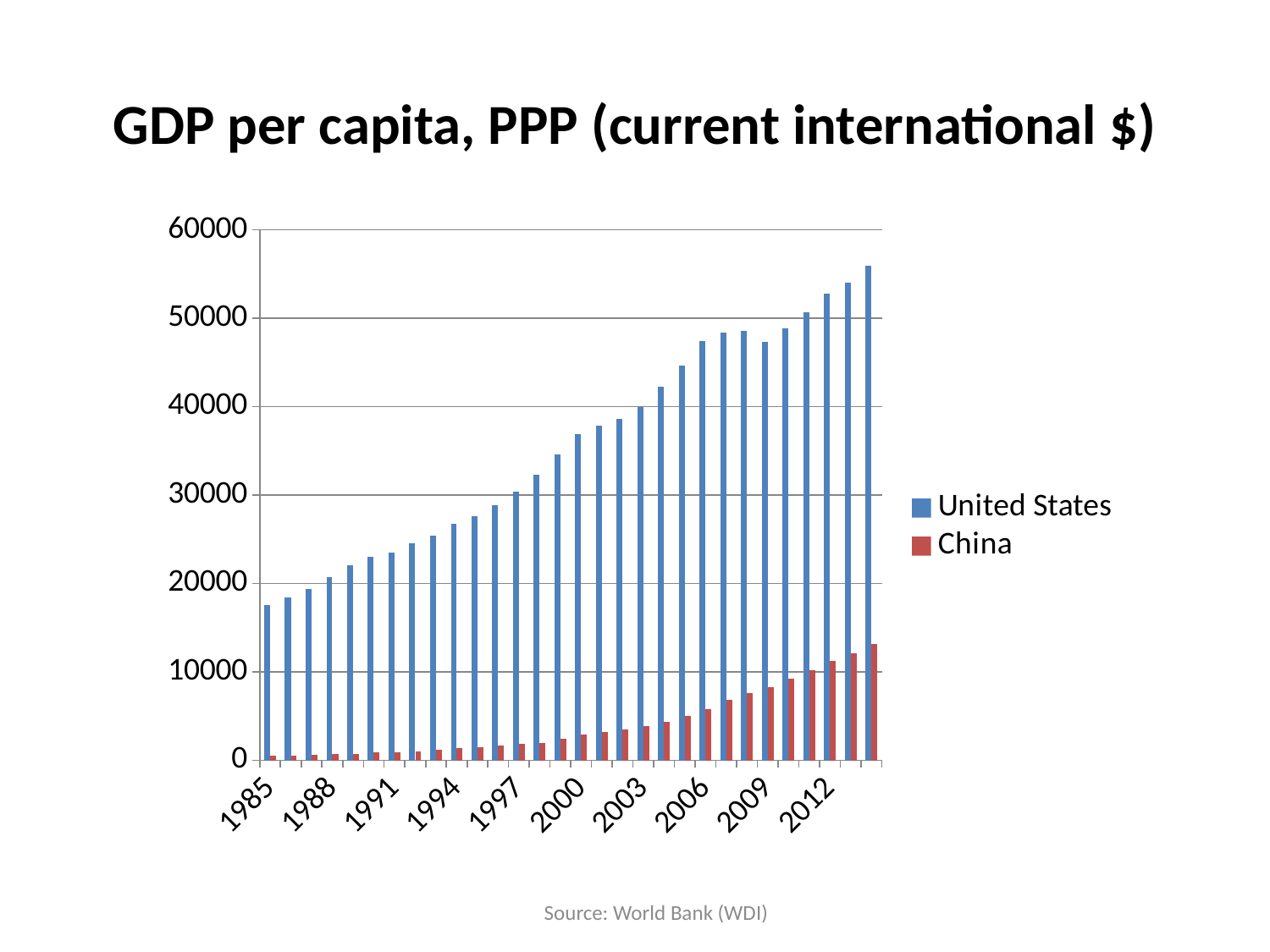
What kind of chart is shown on the slide? bar chart In 2012, which series has the larger value, United States or China? United States Is the value for the United States in 2006 greater or less than 50000? less Is the value for China in 2012 greater or less than 10000? greater Is the value for the United States in 2000 greater or less than 30000? greater What is the title of the chart? GDP per capita, PPP (current international $) Which two series are shown in the legend? United States and China How many series does the legend list? 2 Do the values for China rise or fall from 1985 to 2012? rise